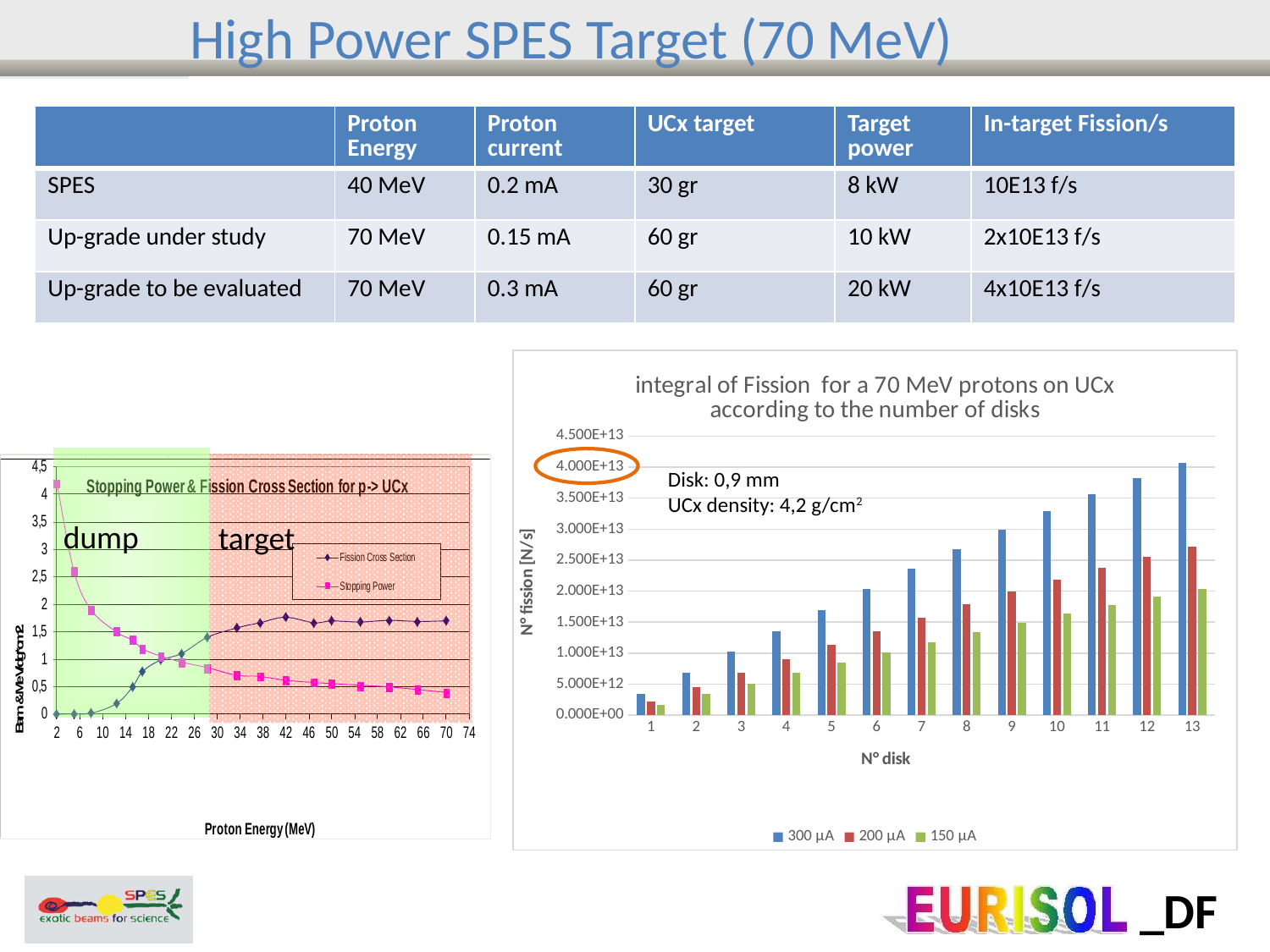
What kind of chart is the chart titled 'integral of Fission for a 70 MeV protons on UCx according to the number of disks'? bar chart How many disk categories are shown on the x axis of the 'integral of Fission' bar chart? 13 In the 'Stopping Power & Fission Cross Section' chart, does the Stopping Power series rise or fall as proton energy increases? fall In the 'integral of Fission' bar chart, is the value for 200 µA at disk 13 greater or less than 2.500E+13? greater In the 'integral of Fission' bar chart, which is larger at disk 13: the 300 µA value or the 150 µA value? 300 µA In the 'integral of Fission' bar chart, do the values for the 300 µA series rise or fall as the number of disks increases? rise In the 'integral of Fission' bar chart, is the value for 300 µA at disk 10 greater or less than 3.000E+13? greater What kind of chart is the chart titled 'Stopping Power & Fission Cross Section for p-> UCx'? line chart In the 'integral of Fission' bar chart, is the value for 150 µA at disk 7 greater or less than 1.000E+13? greater In the 'integral of Fission' bar chart, which series has the tallest bar at disk 13? 300 µA How many series does the legend of the 'integral of Fission' bar chart list? 3